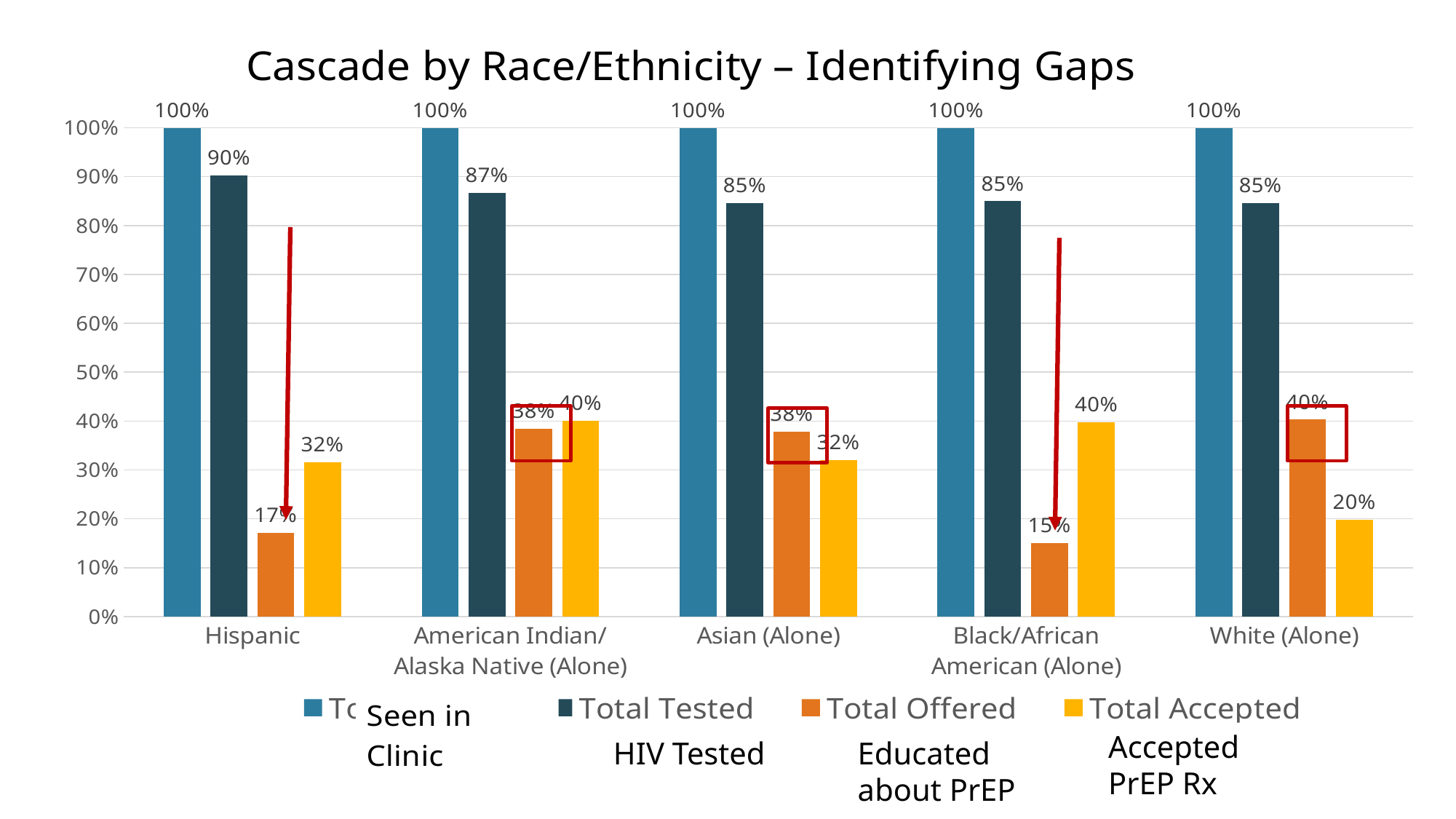
How many race/ethnicity categories are shown on the x axis? 5 Which race/ethnicity category has the highest Total Tested value? Hispanic What is the difference between the Total Tested and Total Offered values for Hispanic? 73 percentage points What kind of chart is shown on the slide? Bar chart Which has the larger Total Accepted value, Asian (Alone) or Black/African American (Alone)? Black/African American (Alone) How many series does the legend list? 4 What is the Total Offered value for Black/African American (Alone)? 15% What is the Total Offered value for American Indian/Alaska Native (Alone)? 38% What is the Total Tested value for Hispanic? 90% What is the Total Accepted value for White (Alone)? 20% Which race/ethnicity category has the lowest Total Offered value? Black/African American (Alone) What is the difference between the Total Offered and Total Accepted values for White (Alone)? 20 percentage points